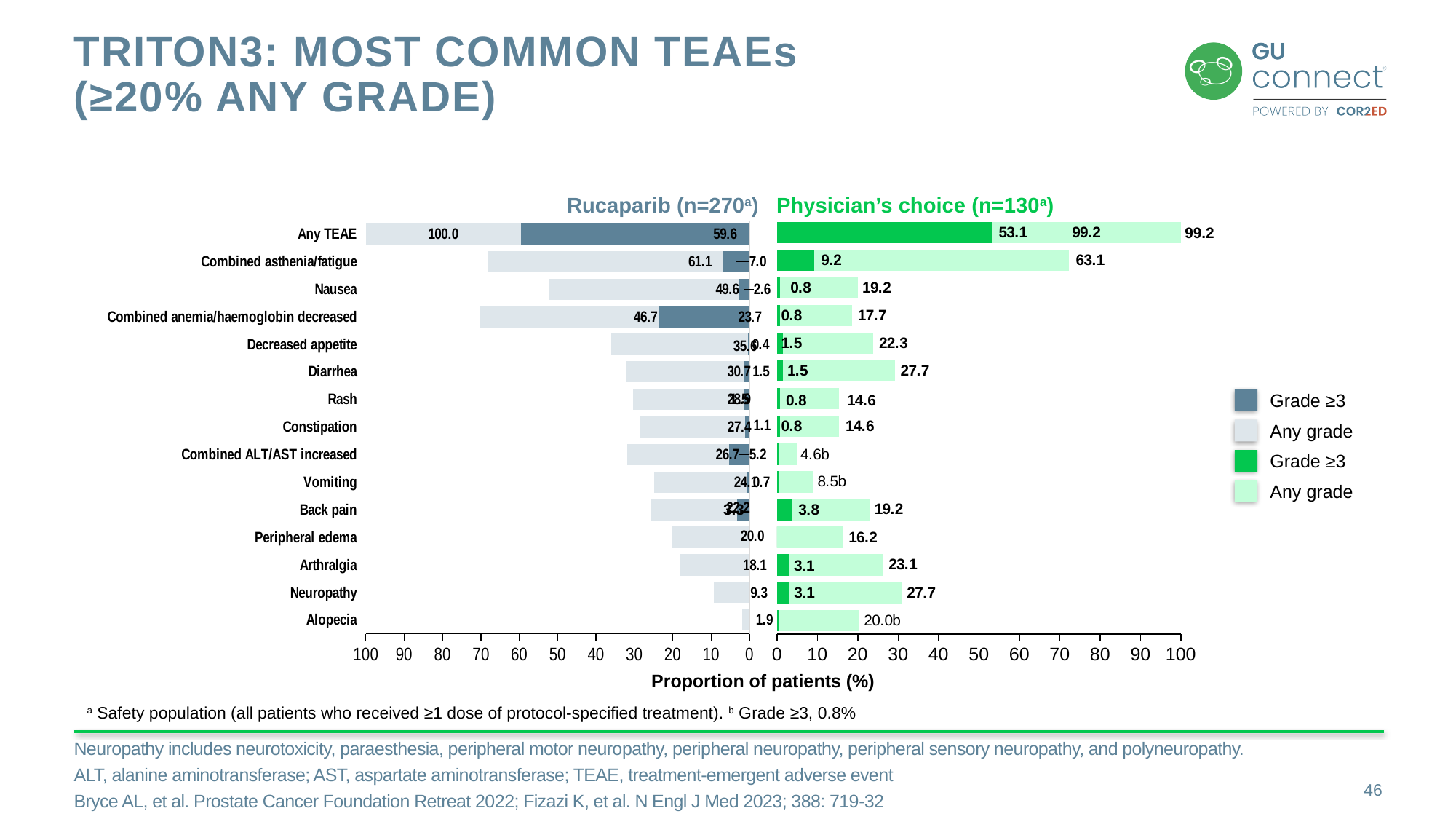
How many TEAE categories are listed on the chart? 15 Which TEAE has the lowest any-grade proportion in the Rucaparib arm? Alopecia What is the any-grade proportion of patients with Combined asthenia/fatigue in the Rucaparib arm? 61.1 What is the Grade ≥3 proportion for Any TEAE in the Physician's choice arm? 53.1 What is the any-grade proportion for Neuropathy in the Physician's choice arm? 27.7 What is the any-grade proportion of patients with Combined asthenia/fatigue in the Physician's choice arm? 63.1 What type of chart is shown on the slide? Bar chart Is the any-grade proportion for Neuropathy higher in the Rucaparib arm or the Physician's choice arm? Physician's choice How many entries does the legend list? 4 What is the difference between the any-grade proportions for Nausea in the Rucaparib arm (49.6) and the Physician's choice arm (19.2)? 30.4 Is the any-grade proportion for Combined anemia/haemoglobin decreased in the Rucaparib arm greater or less than 40? greater What is the Grade ≥3 proportion for Combined anemia/haemoglobin decreased in the Rucaparib arm? 23.7